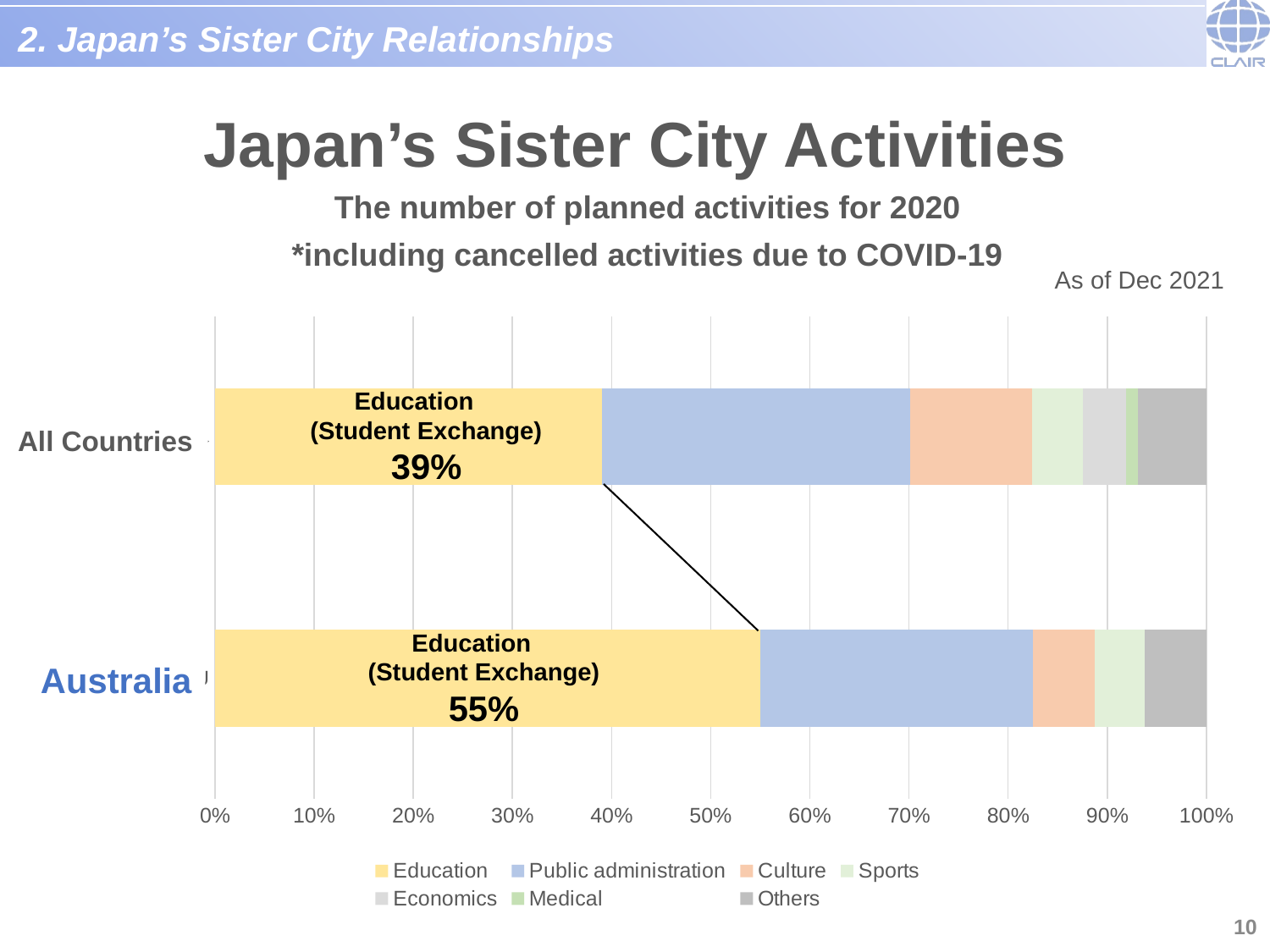
How many series does the legend list? 7 Which has the larger Culture segment, All Countries or Australia? All Countries Which activity type makes up the largest share of All Countries' planned activities? Education Is the Public administration share for All Countries greater or less than 20%? greater What kind of chart is shown on the slide? Stacked bar chart By how many percentage points does Australia's Education share exceed that of All Countries? 16 percentage points What colour represents Education in the chart? Yellow Which activity type makes up the largest share of Australia's planned activities? Education How many bars (categories) are shown in the chart? 2 What percentage of Australia's planned activities is Education (Student Exchange)? 55% What percentage of All Countries' planned activities is Education (Student Exchange)? 39% Which has the larger Education share, All Countries or Australia? Australia